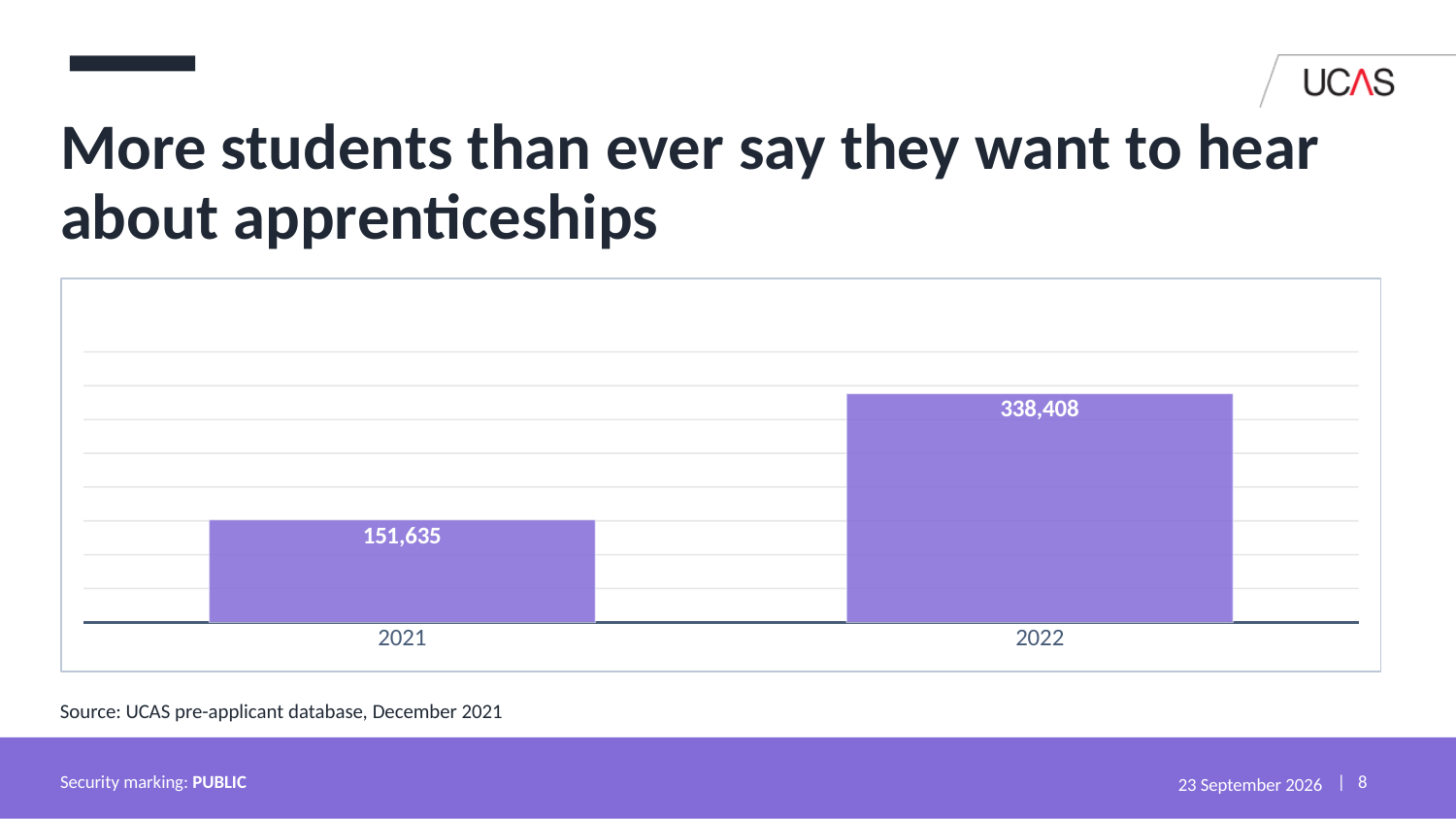
Which year has the lower value? 2021 What source is cited below the chart? UCAS pre-applicant database, December 2021 Do the values rise or fall from 2021 to 2022? rise Which year has the higher value? 2022 Is the value for 2022 larger or smaller than the value for 2021? larger What is the value shown for 2021? 151,635 What is the difference between the 2022 and 2021 values? 186,773 How many categories are shown on the x axis? 2 What kind of chart is shown on the slide? bar chart What is the value shown for 2022? 338,408 What colour are the bars in the chart? purple